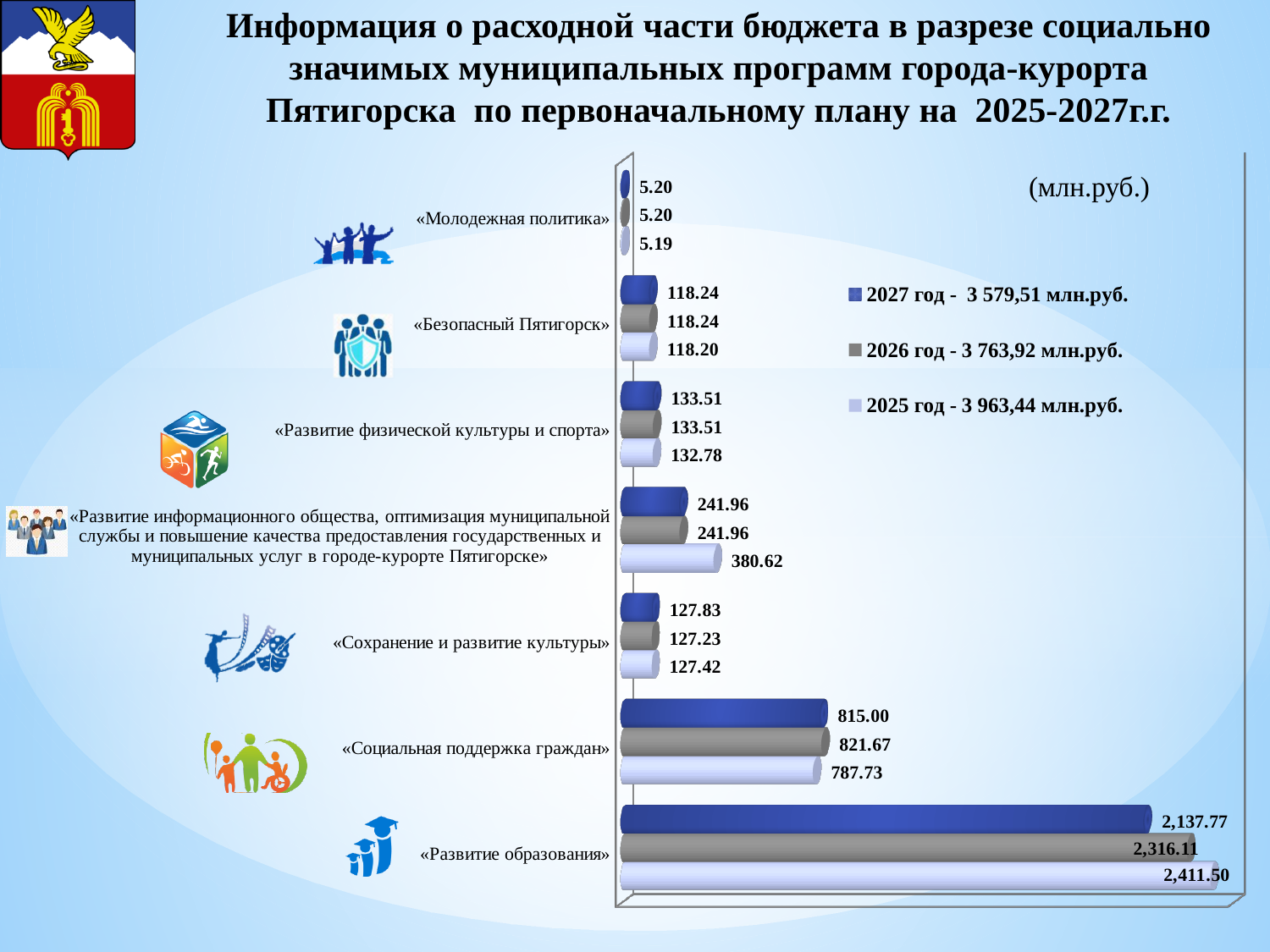
What is the 2027 value for «Социальная поддержка граждан»? 815.00 What is the 2025 value for «Развитие информационного общества, оптимизация муниципальной службы и повышение качества предоставления государственных и муниципальных услуг в городе-курорте Пятигорске»? 380.62 What kind of chart is shown on the slide? Bar chart What is the 2026 value for «Сохранение и развитие культуры»? 127.23 Which program has the lowest 2027 value? «Молодежная политика» For «Социальная поддержка граждан», which year has the larger value, 2026 or 2025? 2026 What is the difference between the 2025 and 2027 values for «Развитие образования»? 273.73 How many series does the legend list? 3 How many programs (categories) are shown in the chart? 7 What is the 2025 value for «Развитие образования»? 2,411.50 Which program has the highest 2026 value? «Развитие образования» What is the difference between the 2026 and 2027 values for «Социальная поддержка граждан»? 6.67